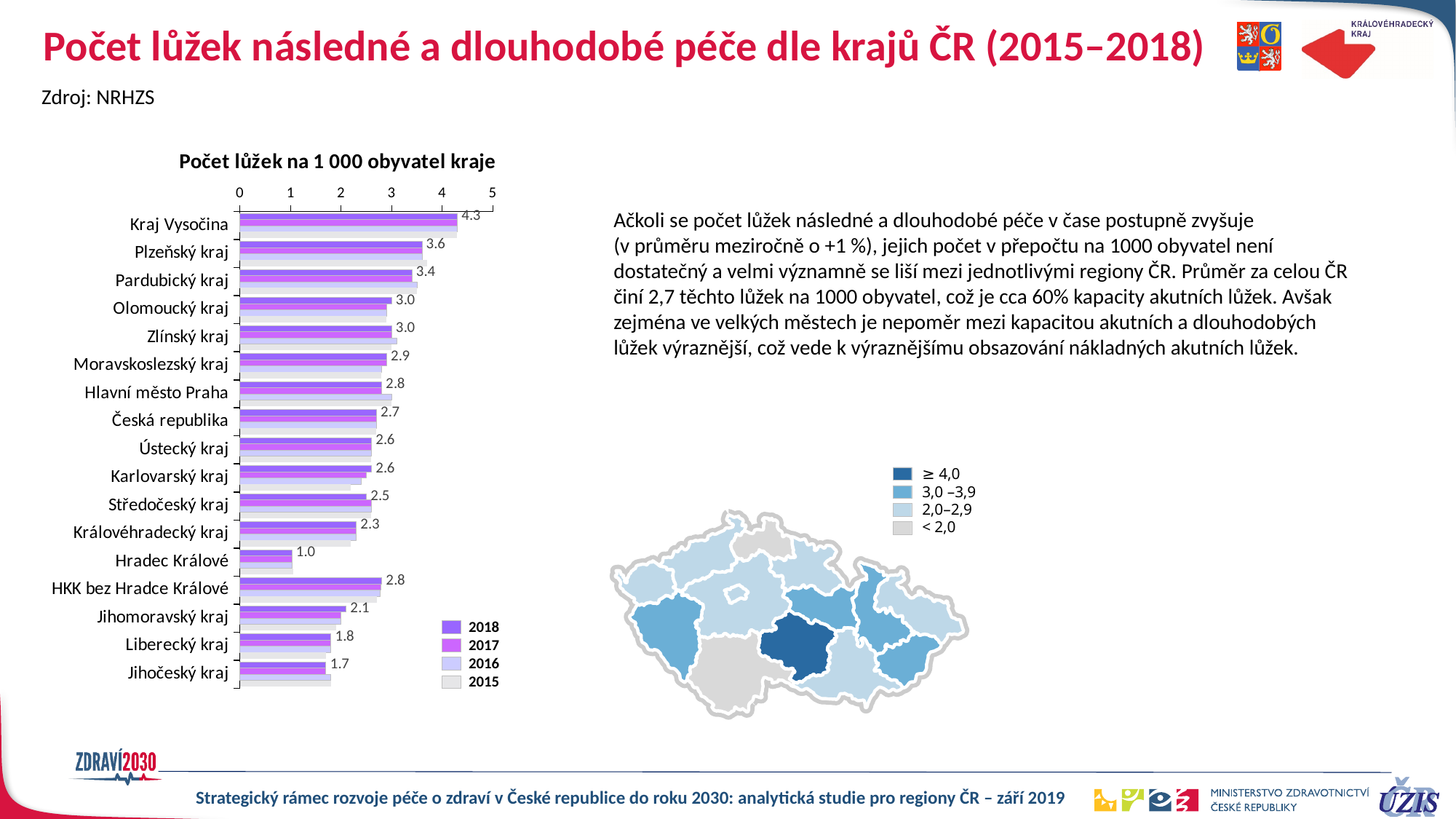
What is the 2018 value for Česká republika? 2.7 What is the 2018 value for Hradec Králové? 1.0 How many series does the legend of the bar chart list? 4 What is the 2018 value for Kraj Vysočina in the chart 'Počet lůžek na 1 000 obyvatel kraje'? 4.3 Which category has the lowest 2018 value? Hradec Králové What is the 2018 value for Královéhradecký kraj? 2.3 Which category has the highest 2018 value? Kraj Vysočina What is the difference between the 2018 values for Kraj Vysočina and Hradec Králové? 3.3 Is the 2015 value for Kraj Vysočina greater or less than 4? greater What type of chart is used to show 'Počet lůžek na 1 000 obyvatel kraje'? Bar chart Which has a larger 2018 value, Plzeňský kraj or Jihočeský kraj? Plzeňský kraj How many categories are shown on the y axis of the bar chart? 17